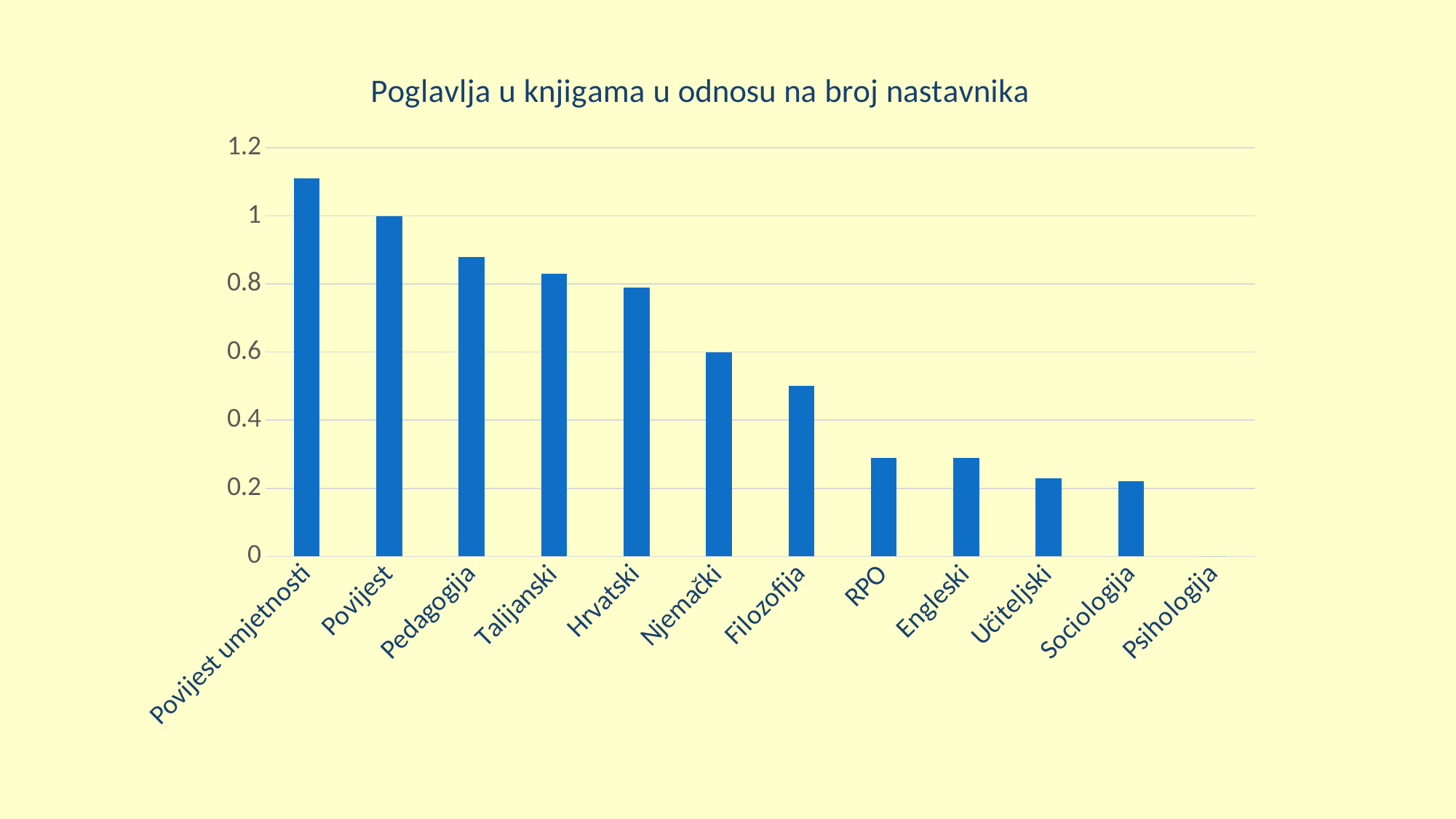
What is the value for Povijest? 1 What is the title of the chart? Poglavlja u knjigama u odnosu na broj nastavnika Is the value for Filozofija greater or less than 0.4? greater What kind of chart is shown on the slide? bar chart Do the values rise or fall from left to right along the x axis? fall Which category has the lowest value in the chart? Psihologija Is the value for Povijest umjetnosti greater or less than 1? greater What is the value for Njemački? 0.6 Which category has the highest value in the chart? Povijest umjetnosti Which is larger, the value for Pedagogija or the value for Hrvatski? Pedagogija How many categories are shown on the x axis of the chart? 12